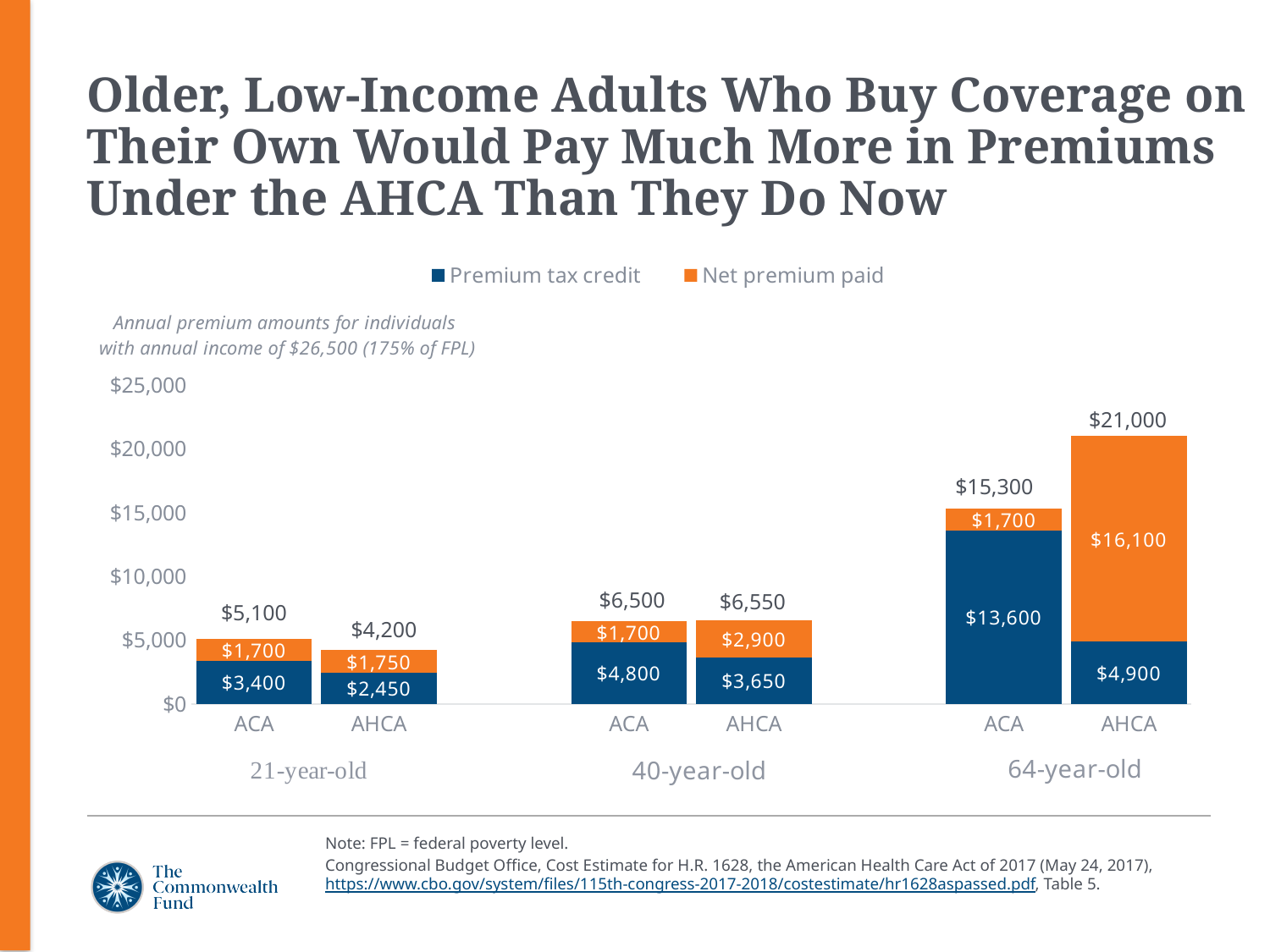
What kind of chart is shown on the slide? Stacked bar chart What is the total annual premium for a 40-year-old under the ACA? $6,500 What colour represents the net premium paid in the chart? Orange What is the total annual premium for a 64-year-old under the AHCA? $21,000 What is the difference in net premium paid for a 64-year-old between the AHCA and the ACA? $14,400 What is the premium tax credit for a 21-year-old under the ACA? $3,400 How many series does the legend list? 2 What is the net premium paid for a 64-year-old under the AHCA? $16,100 How many bars are plotted in the chart? 6 Which bar has the lowest total annual premium? 21-year-old AHCA Is the net premium paid for a 40-year-old larger under the ACA or the AHCA? AHCA Which bar has the highest total annual premium? 64-year-old AHCA